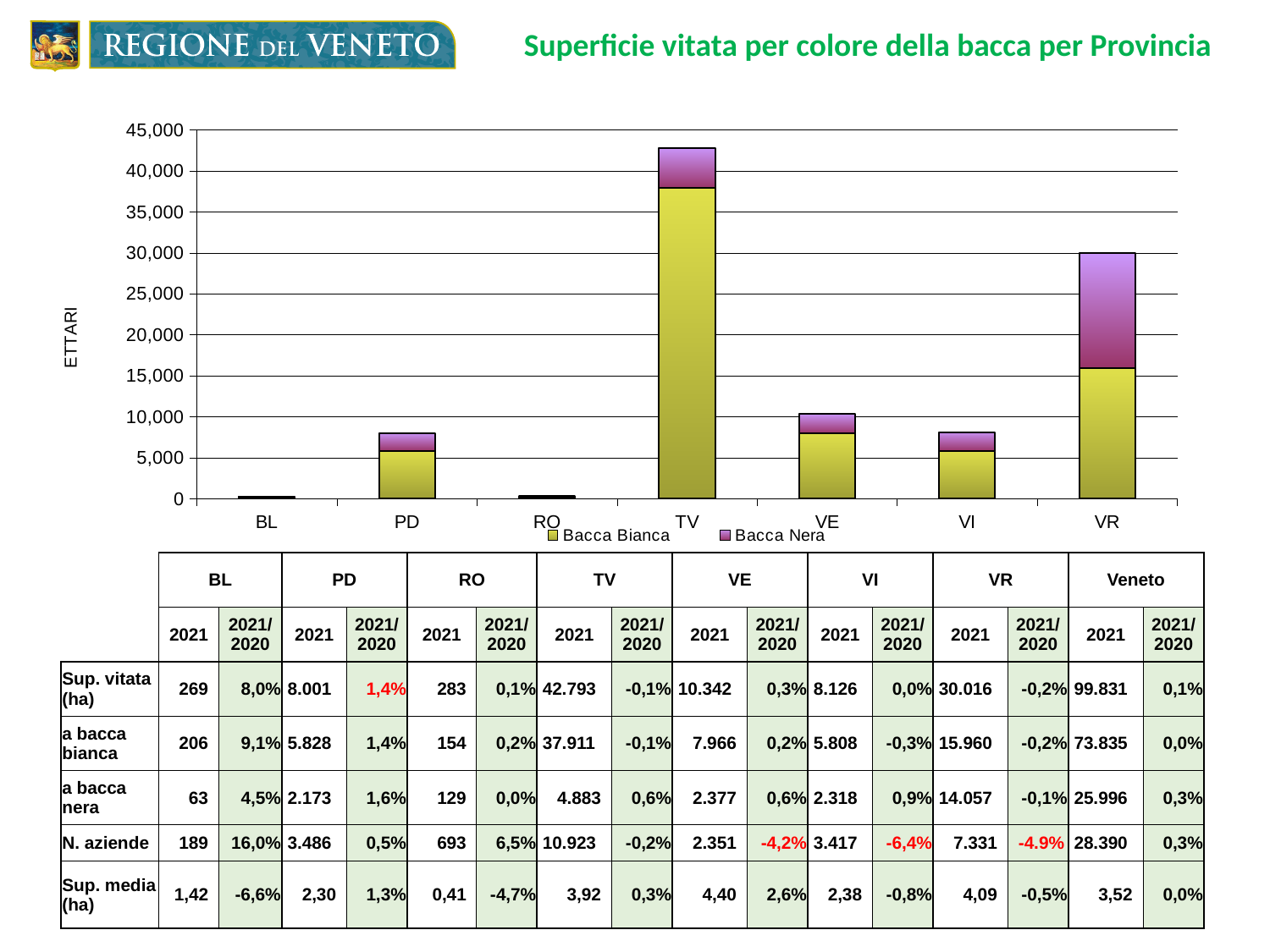
In the TV bar, which segment is larger, Bacca Bianca or Bacca Nera? Bacca Bianca Is the total bar for TV greater or less than 40,000? greater How many provinces (categories) are shown on the x axis of the chart? 7 What is the label on the y axis of the chart? ETTARI How many series does the chart legend list? 2 Is the total bar for VI greater or less than 10,000? less Which bar is taller, VE or VI? VE Is the total bar for VR greater or less than 25,000? greater Which province has the tallest bar in the chart? TV Which province has the shortest bar in the chart? BL What kind of chart is shown on the slide? stacked bar chart